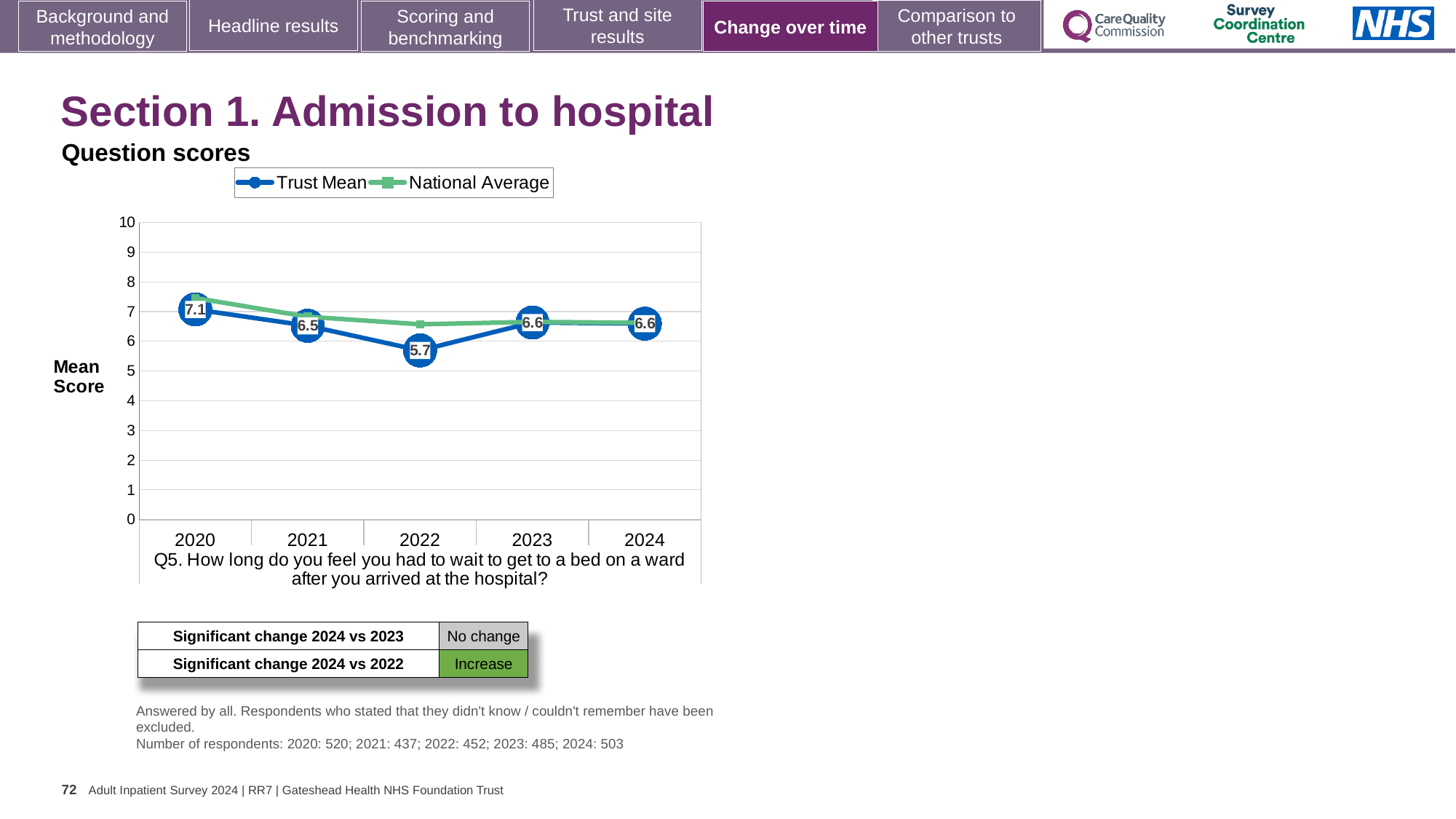
Is the National Average value for 2022 greater or less than 6? greater Does the Trust Mean score rise or fall from 2020 to 2022? fall What is the Trust Mean score for 2022? 5.7 How many series does the chart legend list? 2 What is the Trust Mean score for 2020? 7.1 What is the Trust Mean score for 2024? 6.6 In which year is the Trust Mean score highest? 2020 What kind of chart is shown on the slide? line chart Which is larger, the Trust Mean score for 2021 or for 2023? 2023 What is the difference between the Trust Mean scores for 2020 and 2022? 1.4 How many years are shown on the x axis of the chart? 5 In which year is the Trust Mean score lowest? 2022